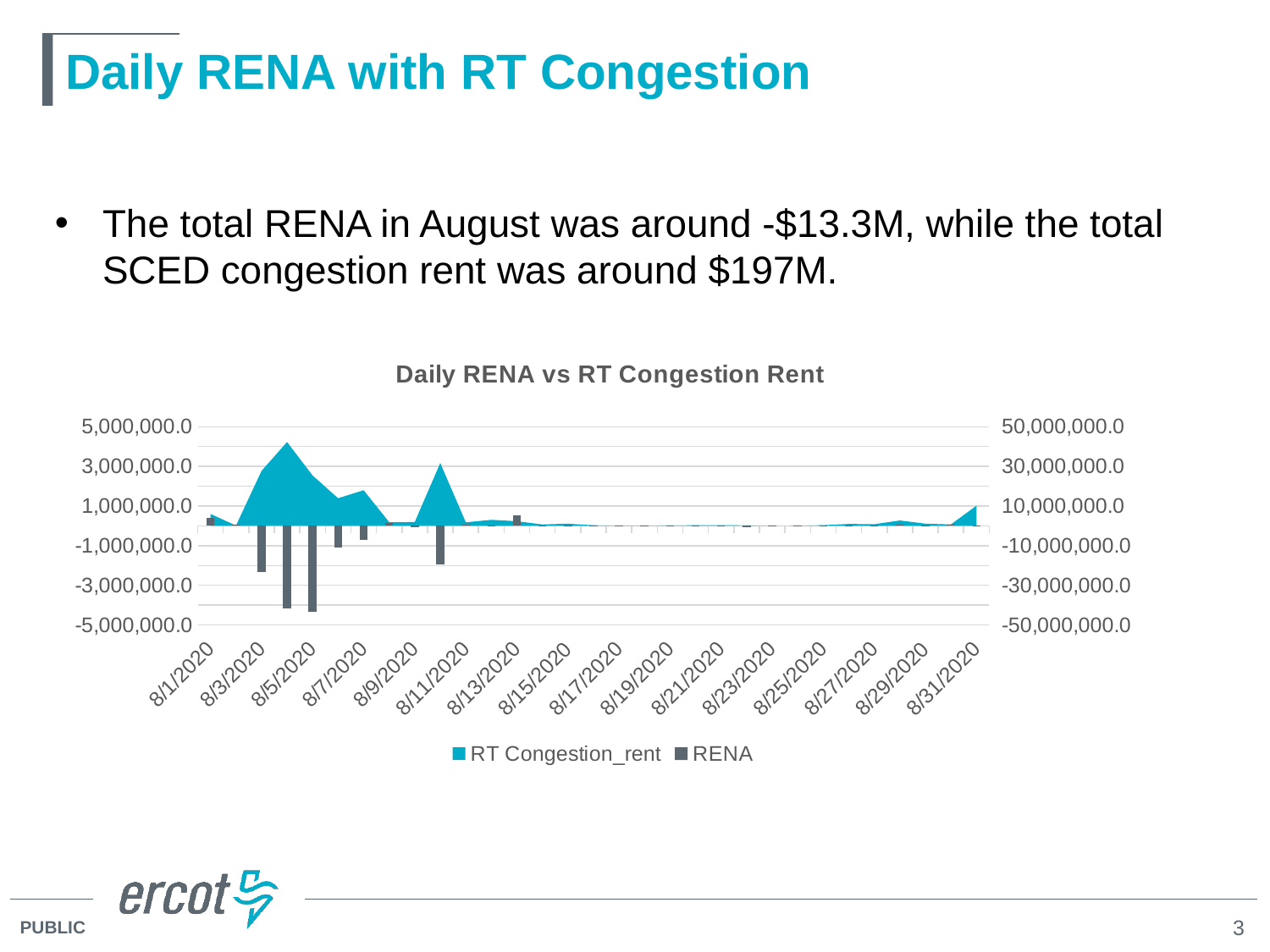
What is the lowest value shown on the right vertical axis of the chart? -50,000,000.0 How many date labels are shown on the x axis of the chart? 16 What is the highest value shown on the left vertical axis of the chart? 5,000,000.0 What are the two series named in the chart legend? RT Congestion_rent and RENA What is the title of the chart? Daily RENA vs RT Congestion Rent Which series in the chart is drawn as bars? RENA Is the RENA value for 8/3/2020 greater or less than -1,000,000.0 on the left axis? less What is the last date label on the x axis of the chart? 8/31/2020 Is the RT Congestion_rent value for 8/11/2020 greater or less than 10,000,000.0 on the right axis? less How many series does the chart legend list? 2 What is the first date label on the x axis of the chart? 8/1/2020